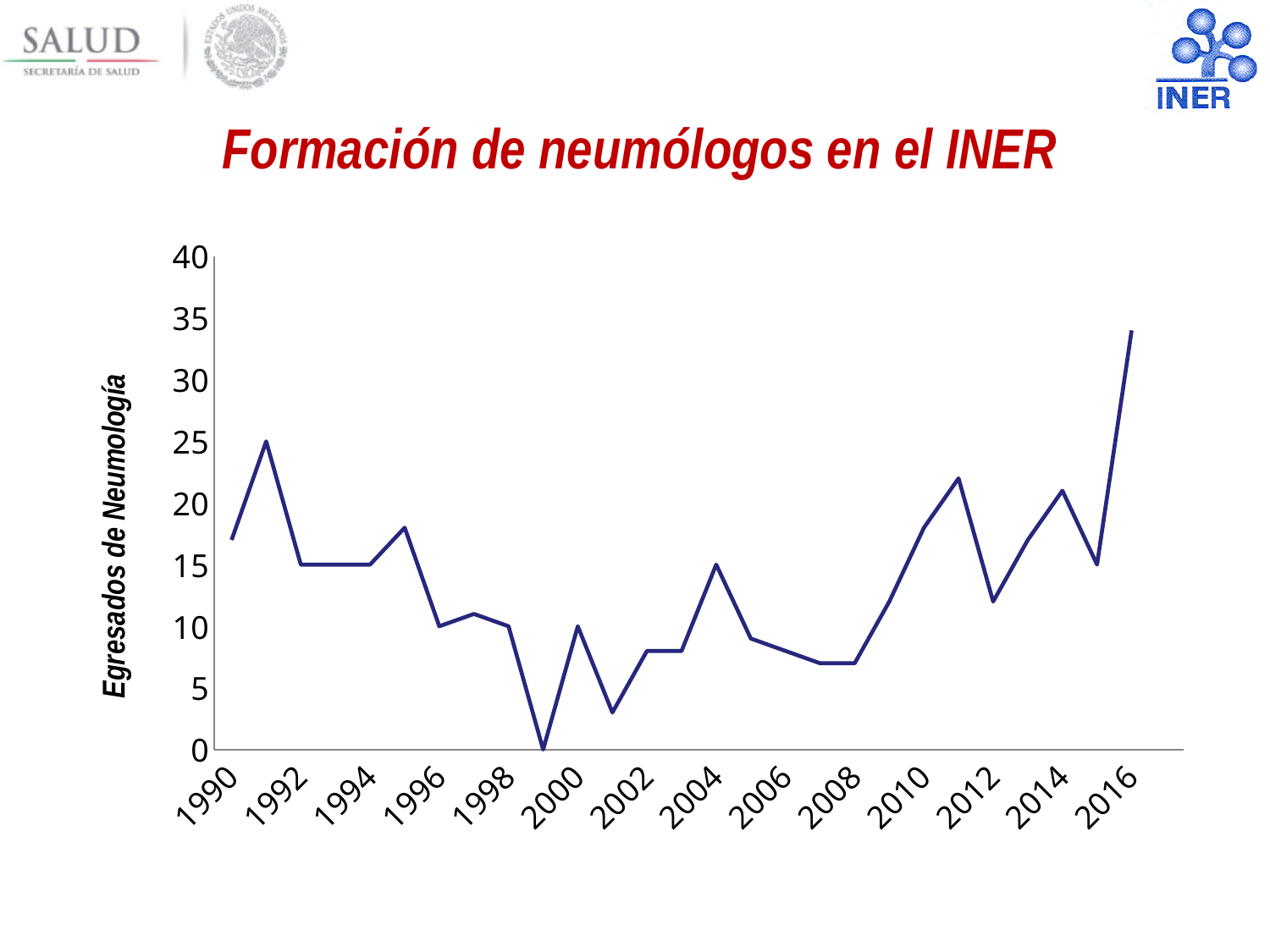
What kind of chart is shown on the slide? line chart In which year is the number of Egresados de Neumología lowest? 1999 What is the label on the vertical axis of the chart? Egresados de Neumología Which year has a larger value, 2011 or 2012? 2011 What is the value for 1999? 0 What is the value for 1991? 25 Does the line rise or fall between 2015 and 2016? rise Is the value for 2011 greater or less than 20? greater Is the value for 2016 greater or less than 30? greater In which year is the number of Egresados de Neumología highest? 2016 What is the title of the chart? Formación de neumólogos en el INER Is the value for 2008 greater or less than 10? less